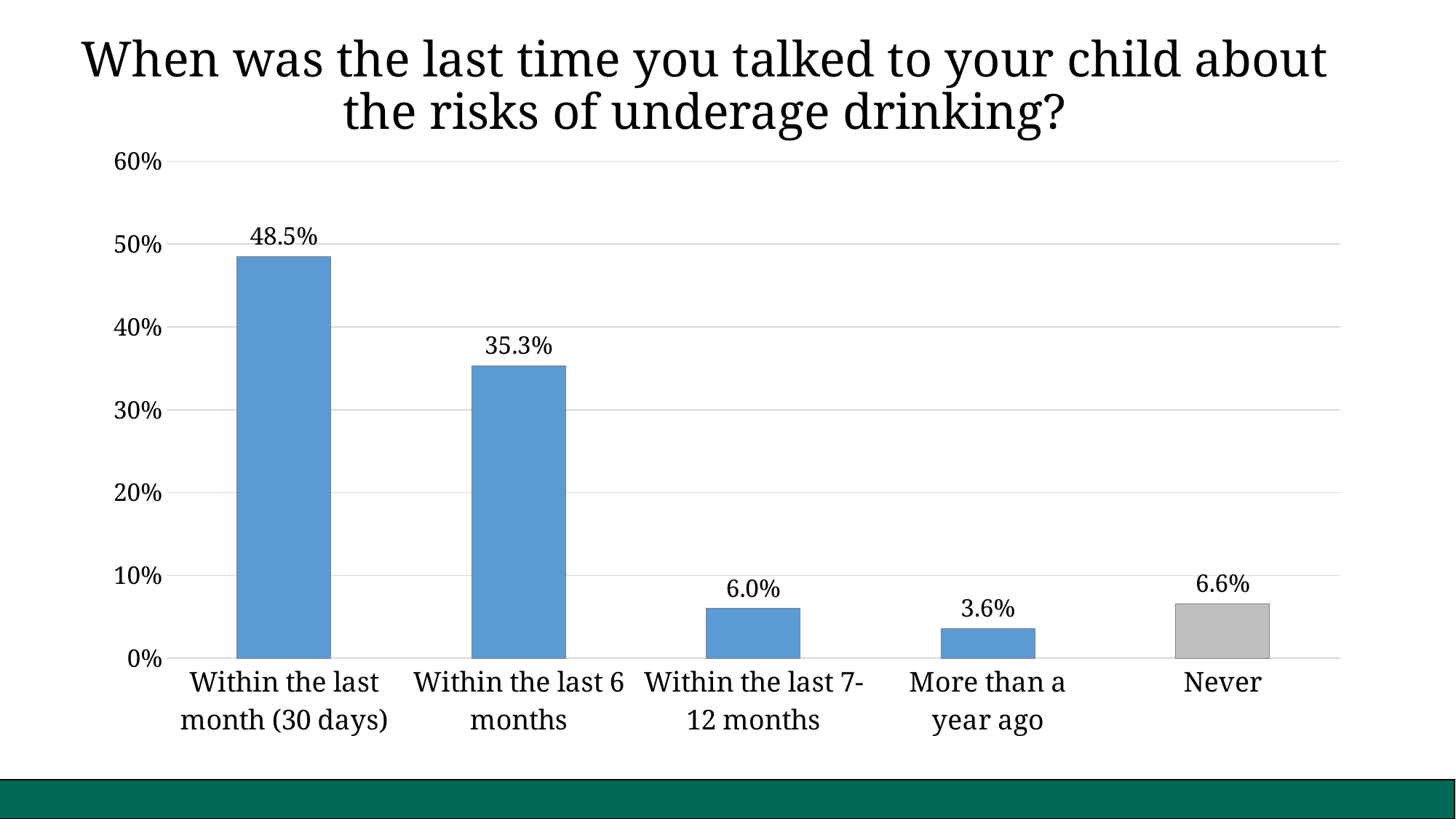
What is the value for 'Within the last 6 months'? 35.3% Which category has the lowest value? More than a year ago What percentage of respondents talked to their child within the last month (30 days)? 48.5% How many categories are shown on the x axis? 5 Which category has the highest value? Within the last month (30 days) Which bar is coloured grey rather than blue? Never Which is larger: 'Never' or 'Within the last 7-12 months'? Never Is the value for 'Within the last 6 months' greater or less than 40%? less What is the value for 'More than a year ago'? 3.6% What is the difference between 'Within the last month (30 days)' and 'Within the last 6 months'? 13.2% What is the value for 'Never'? 6.6% What kind of chart is shown on the slide? Bar chart